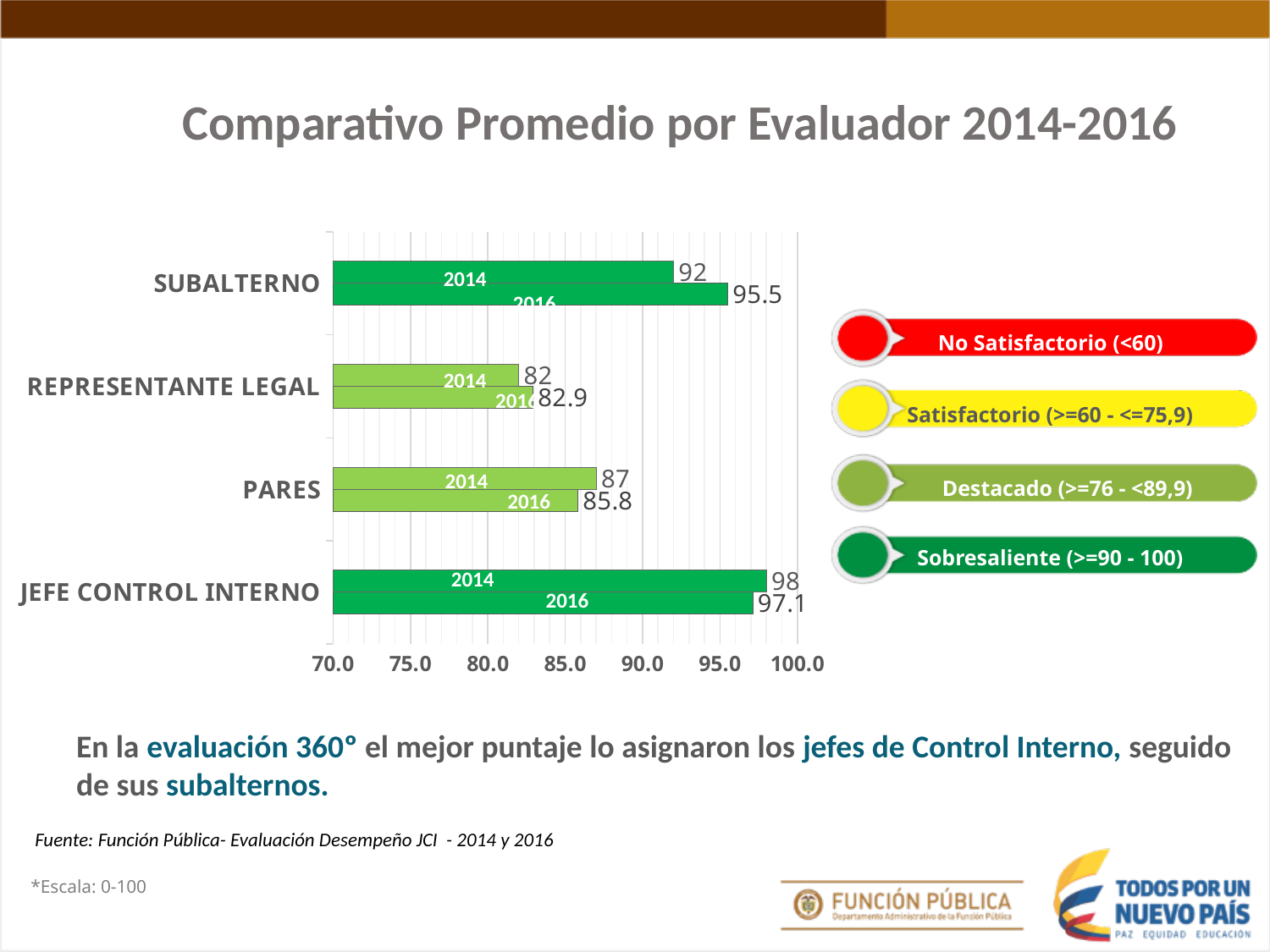
Which is larger for PARES, the 2014 value or the 2016 value? 2014 What kind of chart is shown on the slide? bar chart What is the title of the chart? Comparativo Promedio por Evaluador 2014-2016 What is the 2014 value for REPRESENTANTE LEGAL? 82 What is the 2016 value for PARES? 85.8 How many evaluator categories are shown on the chart? 4 What is the 2014 value for JEFE CONTROL INTERNO? 98 What is the difference between the 2016 and 2014 values for SUBALTERNO? 3.5 Is the 2016 value for REPRESENTANTE LEGAL greater or less than 85.0? less Which evaluator has the lowest 2014 value? REPRESENTANTE LEGAL What is the 2016 value for SUBALTERNO? 95.5 Which evaluator has the highest 2016 value? JEFE CONTROL INTERNO